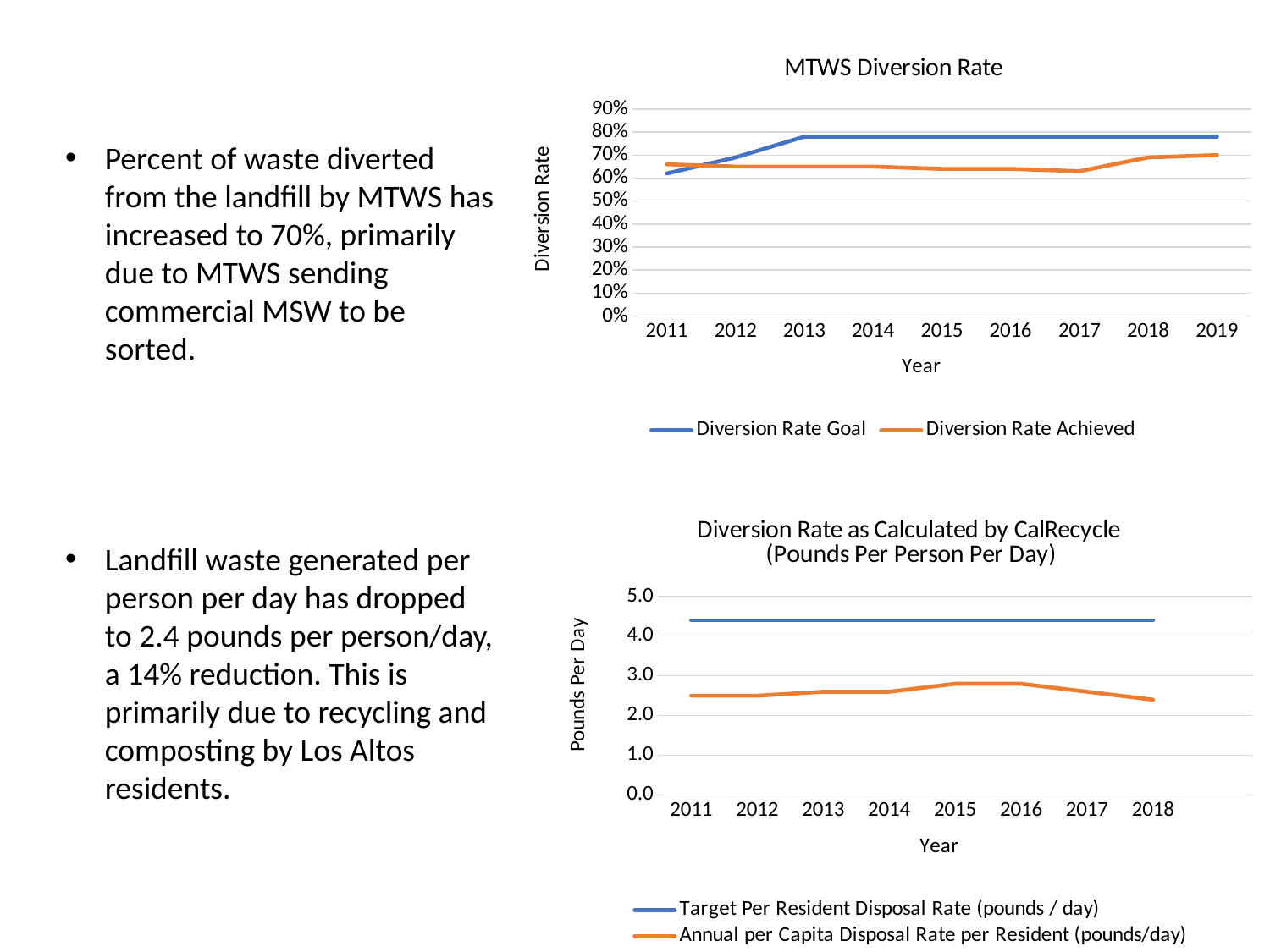
In the 'MTWS Diversion Rate' chart, which series has the higher value in 2019, Diversion Rate Goal or Diversion Rate Achieved? Diversion Rate Goal In the 'MTWS Diversion Rate' chart, is the Diversion Rate Goal value for 2019 greater or less than 70%? greater How many years are shown on the x axis of the 'Diversion Rate as Calculated by CalRecycle' chart? 8 What is the y-axis label of the 'MTWS Diversion Rate' chart? Diversion Rate In the 'MTWS Diversion Rate' chart, is the Diversion Rate Achieved value for 2017 greater or less than 70%? less How many years are shown on the x axis of the 'MTWS Diversion Rate' chart? 9 In the 'Diversion Rate as Calculated by CalRecycle' chart, is the Annual per Capita Disposal Rate per Resident value for 2018 greater or less than 3.0? less In the 'MTWS Diversion Rate' chart, does the Diversion Rate Goal line rise or fall between 2011 and 2013? rise What type of chart is the 'MTWS Diversion Rate' chart? line chart In the 'Diversion Rate as Calculated by CalRecycle' chart, which series has the higher value in 2018, Target Per Resident Disposal Rate or Annual per Capita Disposal Rate per Resident? Target Per Resident Disposal Rate (pounds / day) How many series does the legend of the 'MTWS Diversion Rate' chart list? 2